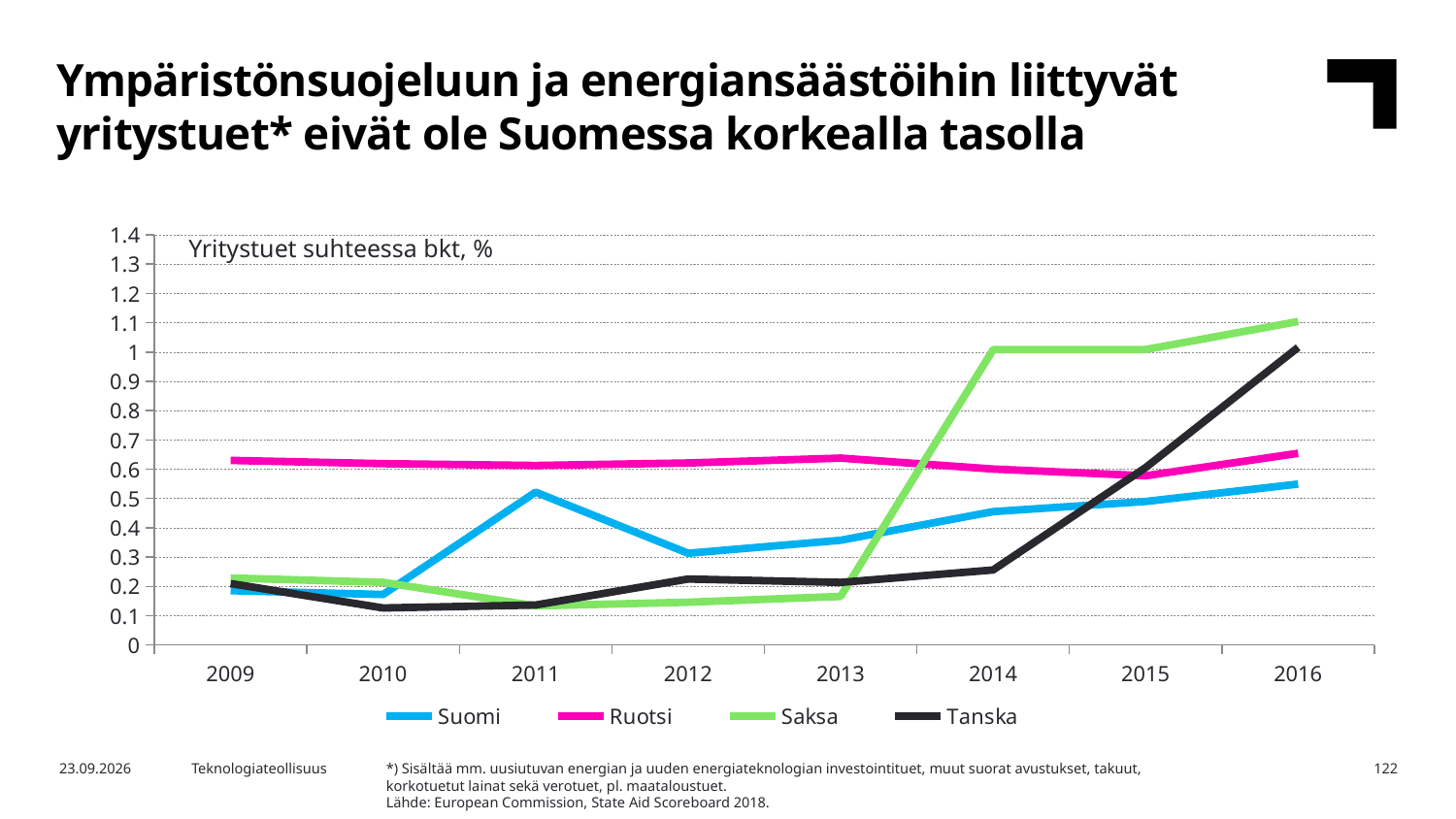
Is the value for Suomi in 2011 greater or less than 0.4? greater Is the value for Saksa in 2016 greater or less than 1? greater Which country has the lowest value in 2016? Suomi What kind of chart is shown on the slide? line chart What is the title shown inside the chart area? Yritystuet suhteessa bkt, % In 2013, which is larger: the value for Suomi or the value for Ruotsi? Ruotsi Which country has the highest value in 2016? Saksa Is the value for Tanska in 2010 greater or less than 0.2? less Which country has the highest value in 2009? Ruotsi How many series does the legend list? 4 How many years are shown on the x axis? 8 Does the value for Tanska rise or fall from 2013 to 2016? rise